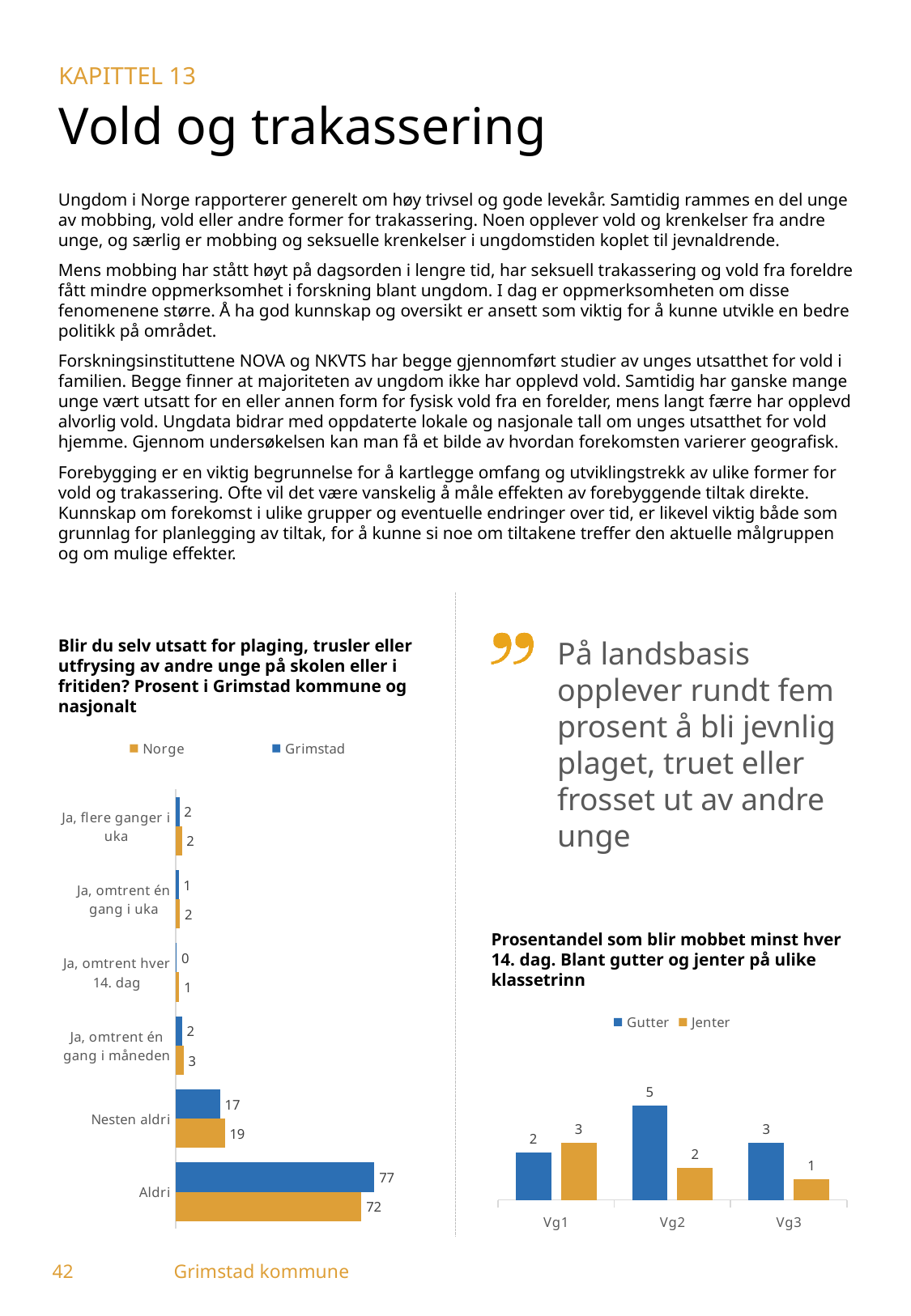
In the left chart (Blir du selv utsatt for plaging...), what is the Grimstad value for "Aldri"? 77 In the left chart (Blir du selv utsatt for plaging...), what is the Grimstad value for "Ja, omtrent hver 14. dag"? 0 In the left chart (Blir du selv utsatt for plaging...), how many series does the legend list? 2 In the left chart (Blir du selv utsatt for plaging...), what is the Norge value for "Nesten aldri"? 19 In the right chart (Prosentandel som blir mobbet minst hver 14. dag), what is the Gutter value for Vg2? 5 In the right chart (Prosentandel som blir mobbet minst hver 14. dag), which class level has the highest Gutter value? Vg2 In the right chart (Prosentandel som blir mobbet minst hver 14. dag), what is the Jenter value for Vg3? 1 In the left chart (Blir du selv utsatt for plaging...), what is the difference between the Grimstad and Norge values for "Aldri"? 5 What kind of chart is the right chart (Prosentandel som blir mobbet minst hver 14. dag)? Bar chart In the left chart (Blir du selv utsatt for plaging...), how many categories are shown? 6 In the left chart (Blir du selv utsatt for plaging...), which category has the highest Norge value? Aldri In the right chart (Prosentandel som blir mobbet minst hver 14. dag), is the Gutter or Jenter value larger for Vg1? Jenter